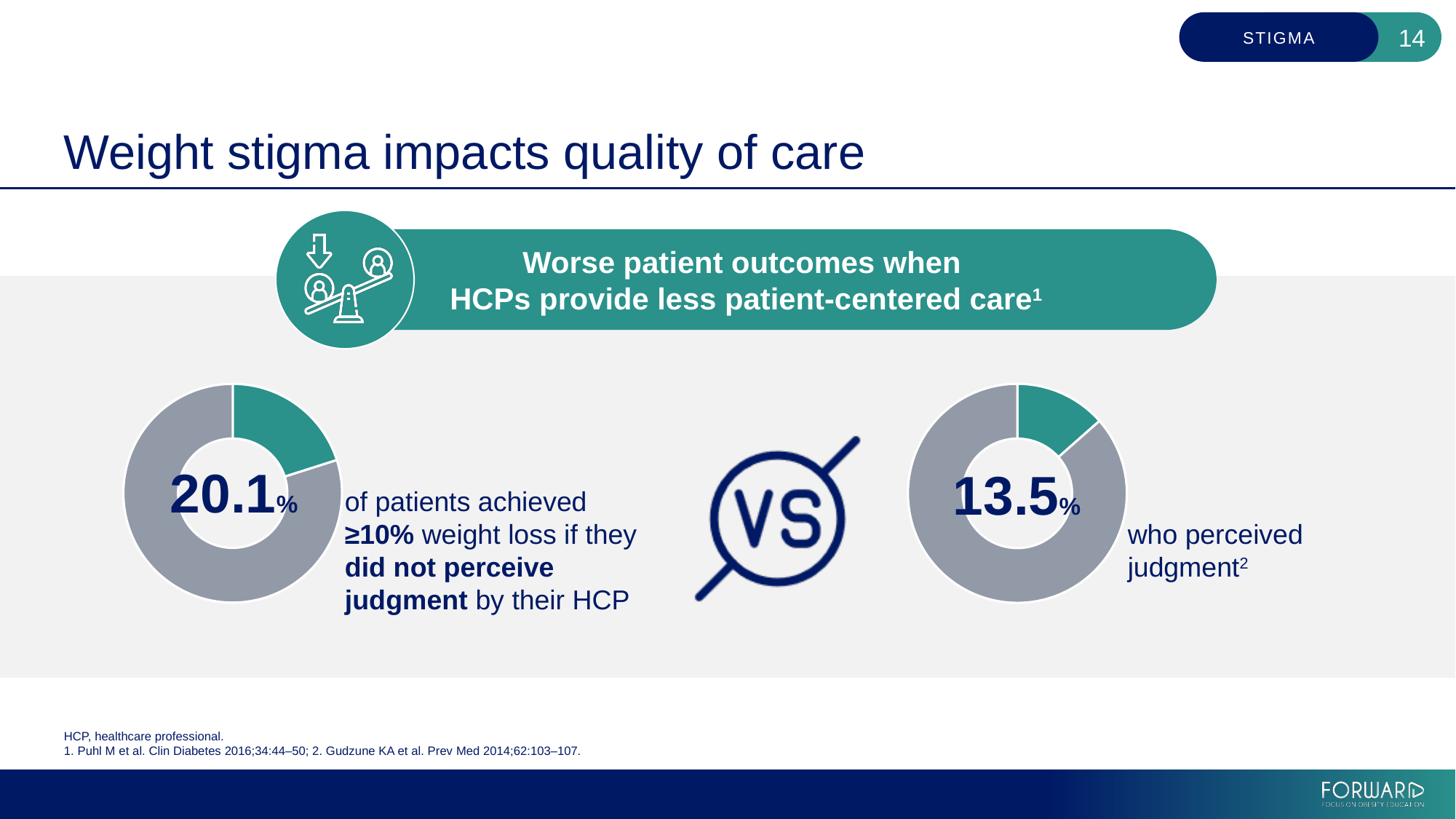
What kind of chart is used to show the 20.1% and 13.5% values on the slide? Donut chart Which group had the higher percentage of patients achieving ≥10% weight loss: those who did not perceive judgment or those who perceived judgment? Those who did not perceive judgment On the right donut chart, what percentage of patients who perceived judgment achieved ≥10% weight loss? 13.5% Which donut chart has the smaller teal slice, the left one or the right one? The right one On the left donut chart, what share of the ring is shown in teal? 20.1% What is the title of the slide containing the two donut charts? Weight stigma impacts quality of care On the right donut chart, what share of the ring is shown in teal? 13.5% What colour is used for the highlighted slice in both donut charts? Teal How many donut charts are shown on the slide? 2 On the left donut chart, what percentage of patients achieved ≥10% weight loss if they did not perceive judgment by their HCP? 20.1% What is the difference in percentage points between the left donut chart value (20.1%) and the right donut chart value (13.5%)? 6.6 percentage points